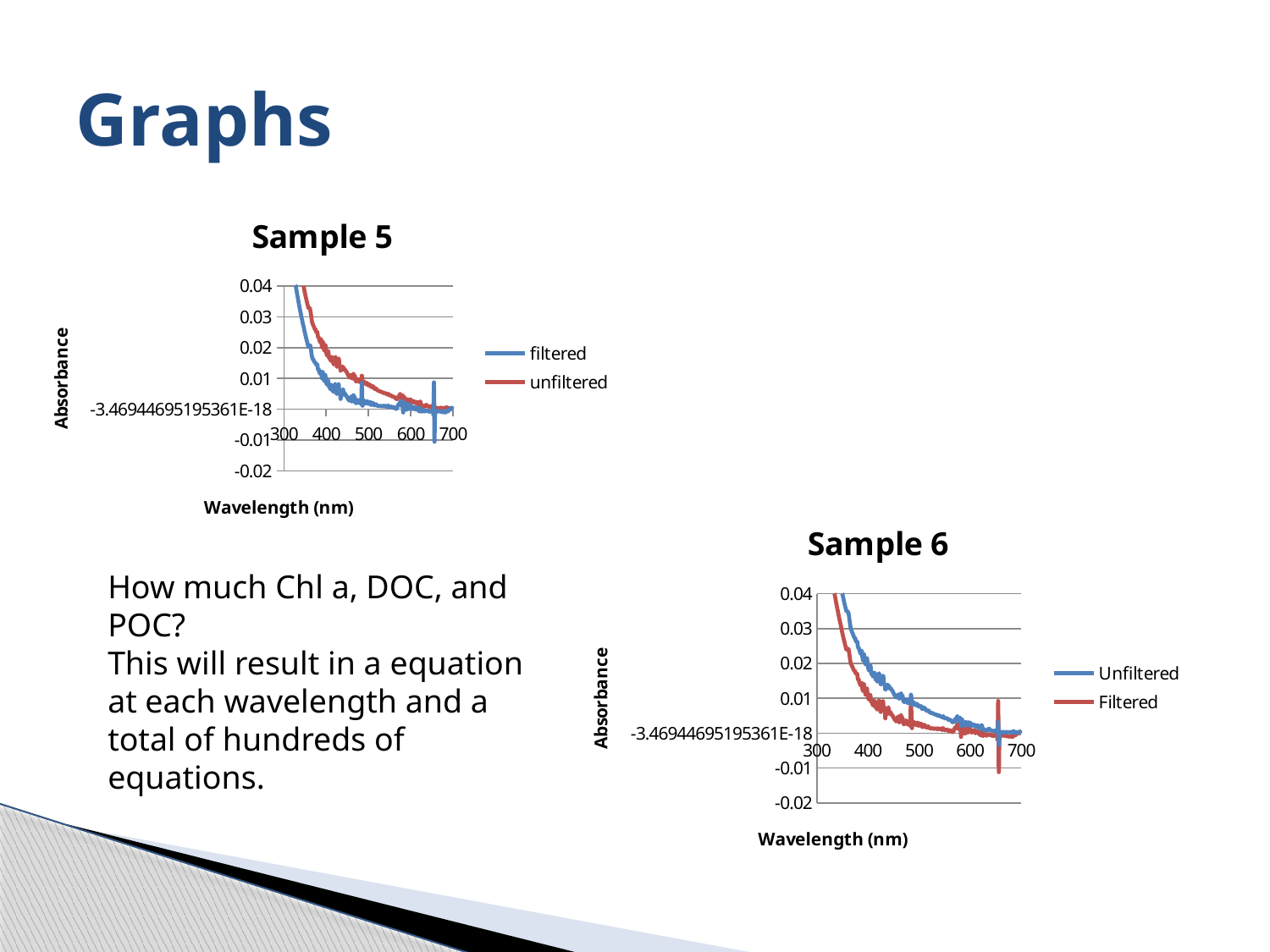
How many series does the legend of the Sample 6 chart list? 2 In the Sample 5 chart, is the absorbance of the filtered series at 600 nm greater or less than 0.01? less What are the two legend entries in the Sample 5 chart? filtered and unfiltered What kind of chart is the Sample 6 chart? line chart In the Sample 5 chart, do the absorbance values rise or fall as wavelength increases from 300 to 700 nm? fall In the Sample 6 chart, which series has the higher absorbance at 400 nm, Unfiltered or Filtered? Unfiltered In the Sample 6 chart, is the absorbance of the Unfiltered series at 400 nm greater or less than 0.01? greater In the Sample 5 chart, which series has the higher absorbance at 400 nm, filtered or unfiltered? unfiltered In the Sample 6 chart, do the absorbance values rise or fall as wavelength increases from 300 to 700 nm? fall What kind of chart is the Sample 5 chart? line chart How many series does the legend of the Sample 5 chart list? 2 What is the x-axis title of the Sample 6 chart? Wavelength (nm)